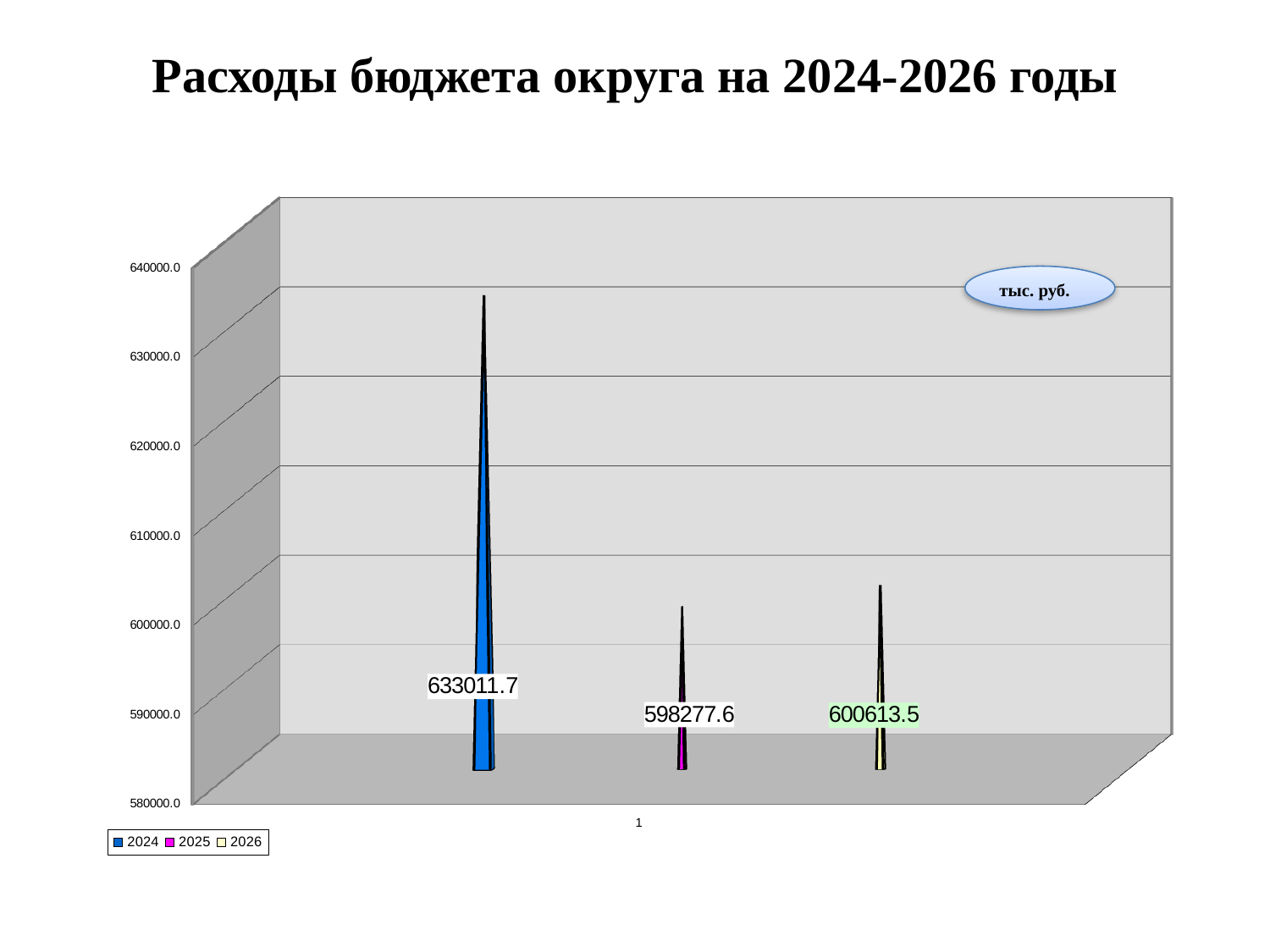
What is the difference between the values for 2026 and 2025? 2335.9 Which year has the lowest value? 2025 What is the difference between the values for 2024 and 2025? 34734.1 What is the value for 2025? 598277.6 Is the value for 2024 greater or less than 620000.0? greater What is the value for 2026? 600613.5 How many series does the legend list? 3 Which is larger, the value for 2025 or the value for 2026? 2026 What is the title of the chart? Расходы бюджета округа на 2024-2026 годы What kind of chart is shown on the slide? bar chart What is the value for 2024? 633011.7 Which year has the highest value? 2024